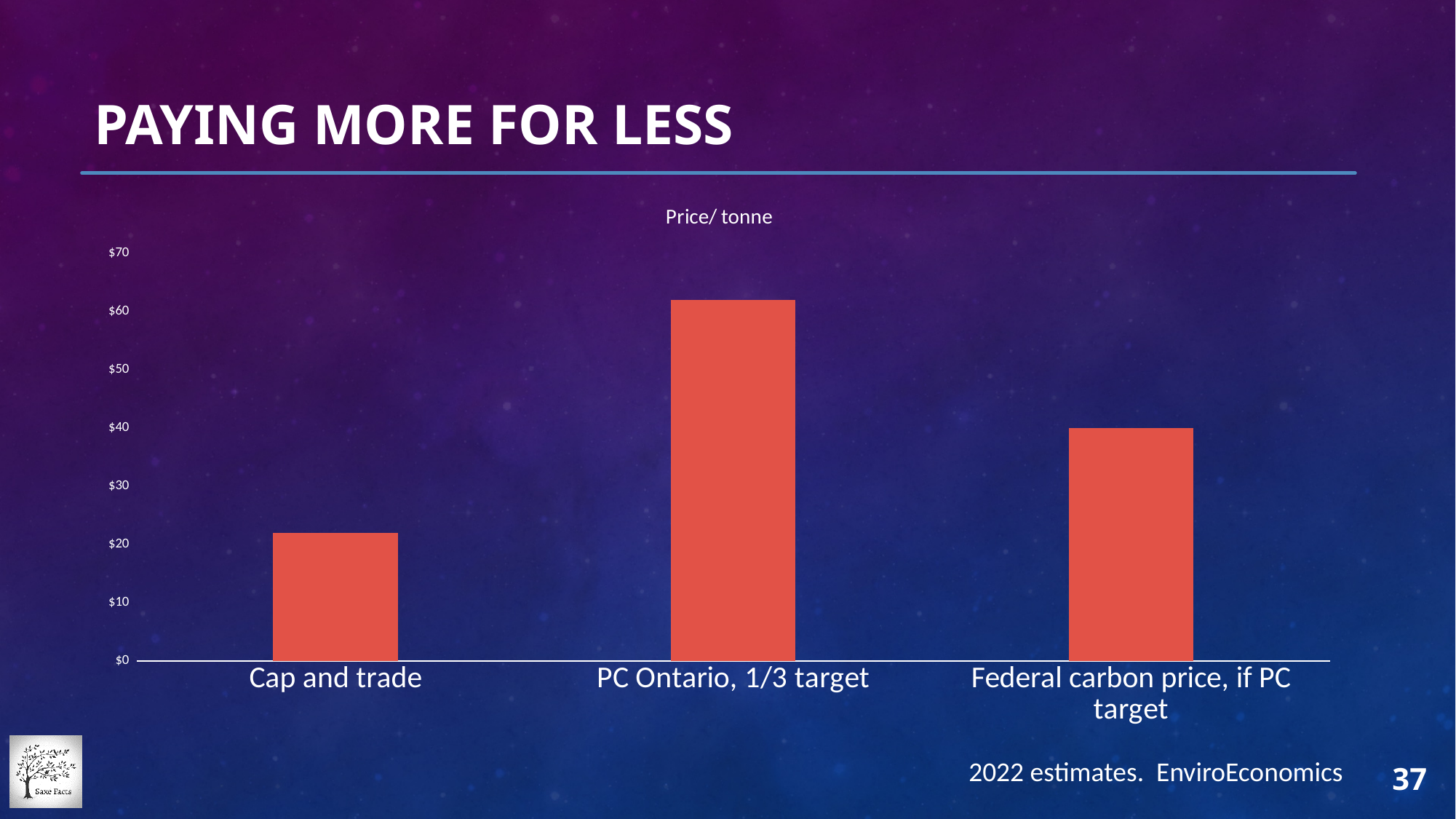
Which is larger, the value for Cap and trade or the value for Federal carbon price, if PC target? Federal carbon price, if PC target How many categories are plotted in the chart? 3 What is the value for Federal carbon price, if PC target? $40 What colour are the bars in the chart? red Is the value for PC Ontario, 1/3 target greater or less than $60? greater Is the value for Cap and trade greater or less than $20? greater Which is larger, the value for PC Ontario, 1/3 target or the value for Federal carbon price, if PC target? PC Ontario, 1/3 target What is the title of the chart? Price/ tonne Which category has the lowest price per tonne? Cap and trade Which category has the highest price per tonne? PC Ontario, 1/3 target Is the value for Cap and trade greater or less than $30? less What kind of chart is shown on the slide? bar chart